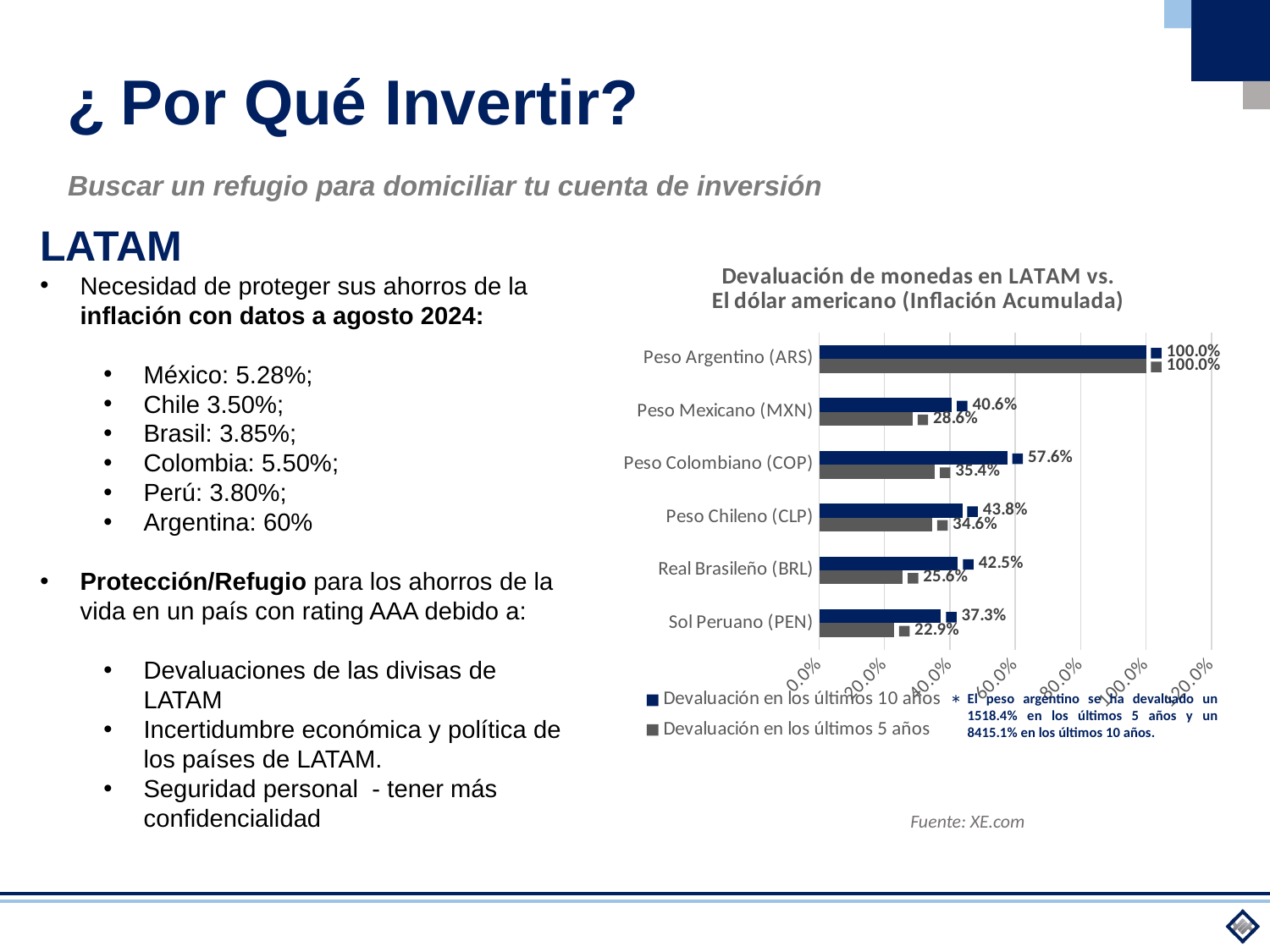
Which is larger: the 10-year devaluation of the Peso Chileno (CLP) or of the Real Brasileño (BRL)? Peso Chileno (CLP) Is the 10-year devaluation for the Peso Colombiano (COP) greater or less than 40.0%? greater How many series does the chart's legend list? 2 What is the devaluation in the last 5 years for the Real Brasileño (BRL)? 25.6% What is the difference between the 10-year and 5-year devaluation for the Peso Mexicano (MXN)? 12.0% Which currency has the lowest devaluation in the last 5 years? Sol Peruano (PEN) Which currency has the highest devaluation in the last 10 years? Peso Argentino (ARS) What is the devaluation in the last 5 years for the Sol Peruano (PEN)? 22.9% What source is cited below the chart? XE.com What is the devaluation in the last 10 years for the Peso Colombiano (COP)? 57.6% What type of chart is shown on the slide? Bar chart How many currencies are plotted in the chart? 6